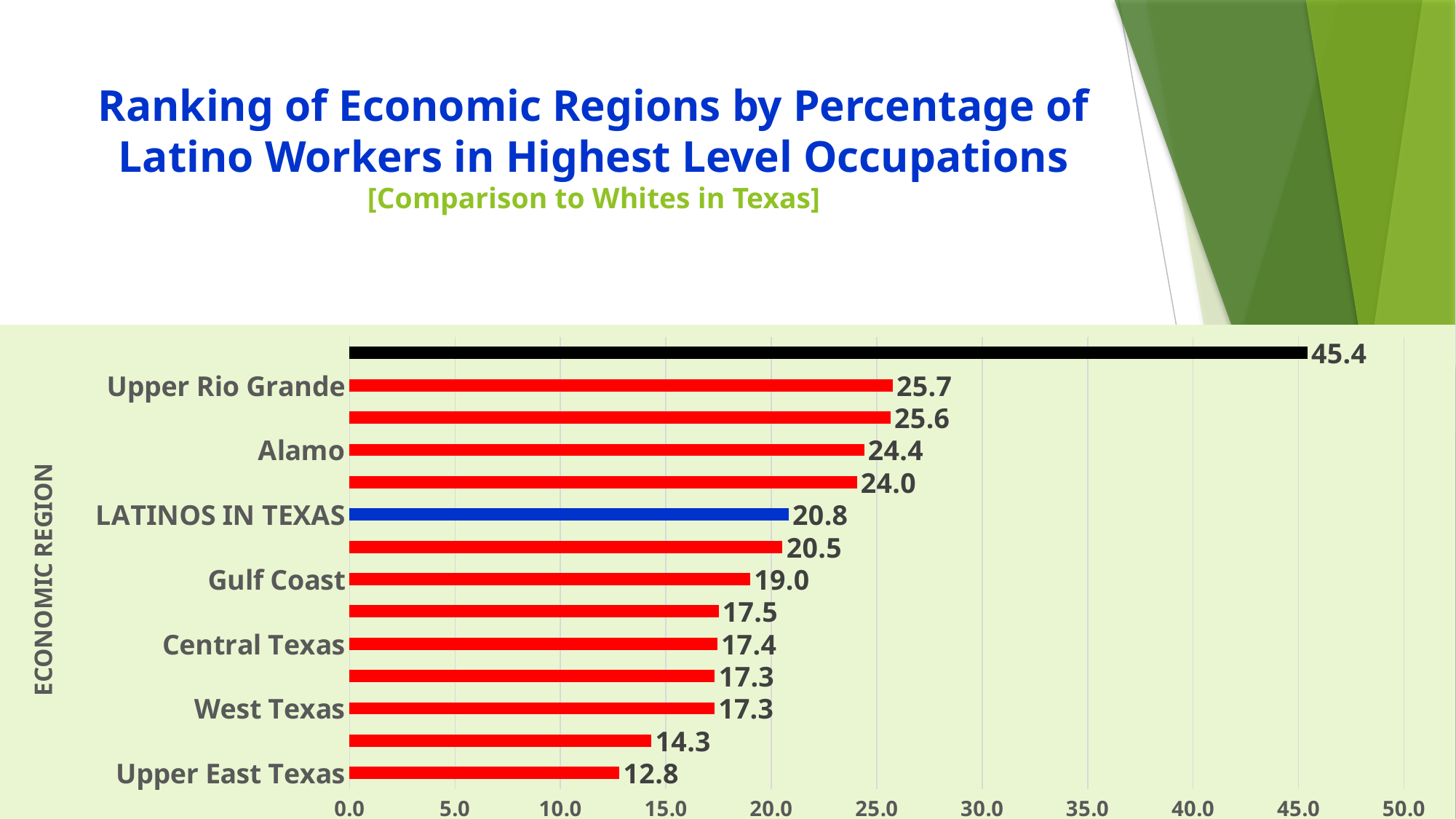
What is the value for LATINOS IN TEXAS? 20.8 What is the value for Upper Rio Grande? 25.7 What kind of chart is shown on the slide? Bar chart What is the value for Gulf Coast? 19.0 Which has a larger value, Alamo or Gulf Coast? Alamo What is the value for Upper East Texas? 12.8 Which labeled economic region has the lowest value? Upper East Texas What is the difference between the values for LATINOS IN TEXAS and Gulf Coast? 1.8 What is the difference between the values for Upper Rio Grande and Alamo? 1.3 What is the title of the vertical axis? ECONOMIC REGION Is the value for Central Texas greater or less than 20.0? less How many bars are plotted in the chart? 14